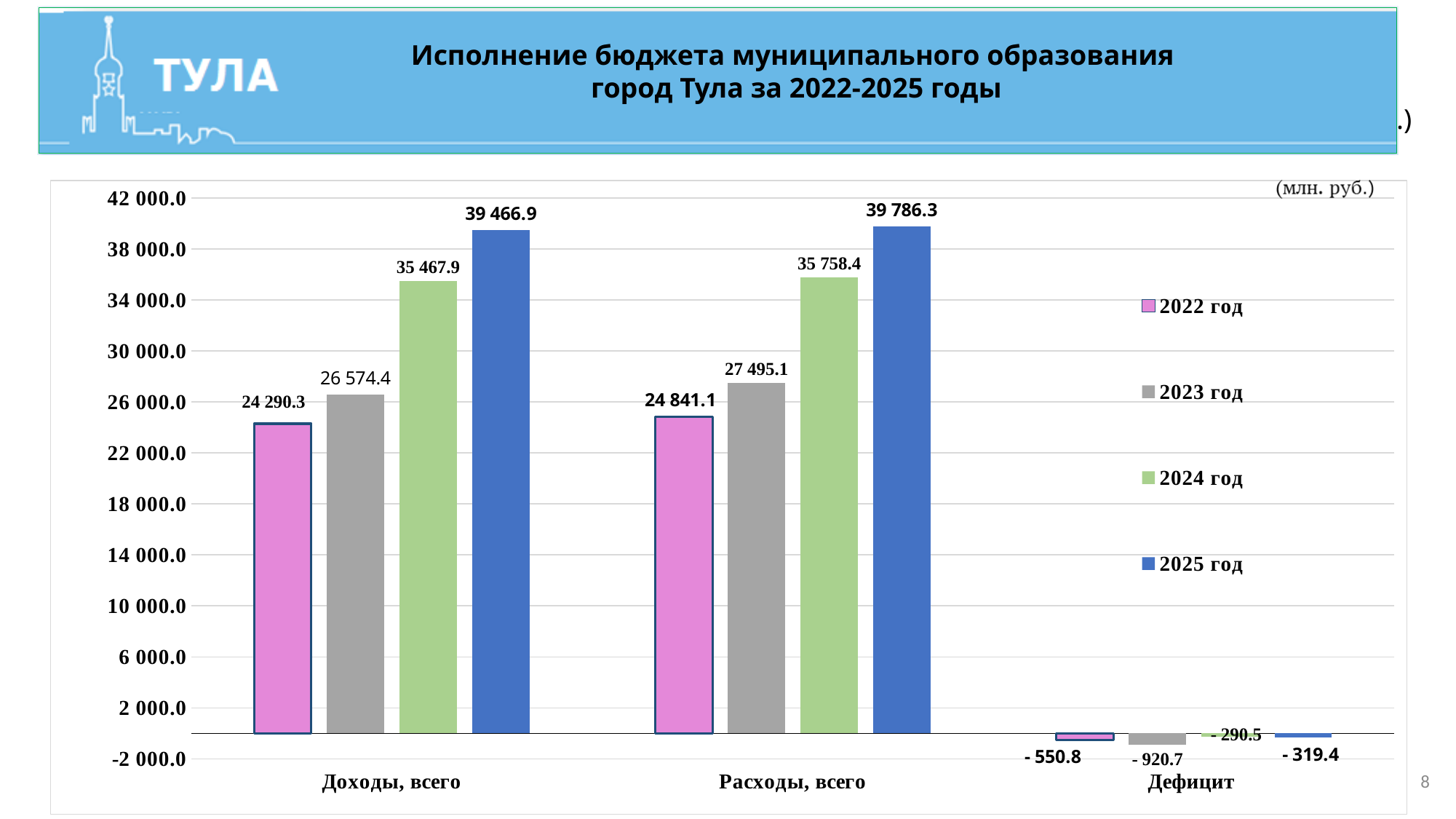
Which is larger: the 2024 год value for Доходы, всего or the 2024 год value for Расходы, всего? Расходы, всего How many series does the legend list? 4 What is the difference between the 2023 год and 2022 год values in the Доходы, всего category? 2 284.1 Do the values in the Доходы, всего category rise or fall from 2022 год to 2025 год? rise What is the value for 2022 год in the Расходы, всего category? 24 841.1 What is the value for 2025 год in the Доходы, всего category? 39 466.9 What kind of chart is shown on the slide? bar chart Which year has the lowest value in the Доходы, всего category? 2022 год Which year has the highest value in the Расходы, всего category? 2025 год What is the difference between Расходы, всего and Доходы, всего for 2025 год? 319.4 What is the value for 2023 год in the Дефицит category? - 920.7 Is the value for 2023 год in the Расходы, всего category greater or less than 30 000.0? less